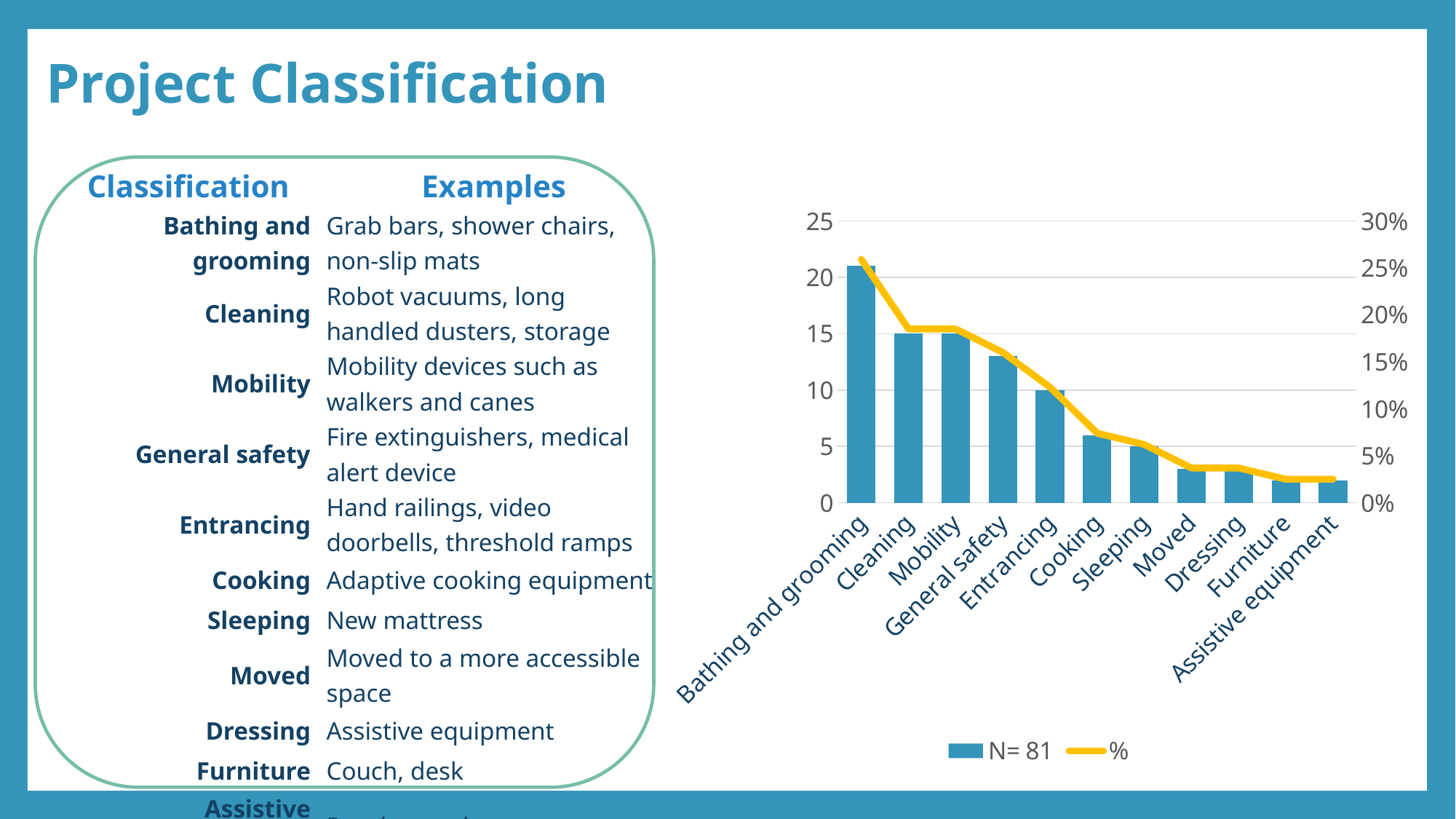
Is the N= 81 value for Moved greater or less than 5? less Do the bar values rise or fall from left to right along the x axis? fall Is the N= 81 value for General safety greater or less than 15? less What are the two entries in the chart legend? N= 81 and % Is the N= 81 value for Bathing and grooming greater or less than 20? greater What is the N= 81 value for Sleeping? 5 Which has a larger N= 81 value, General safety or Entrancing? General safety How many categories are shown on the x axis of the chart? 11 Which category has the highest bar in the chart? Bathing and grooming How many series does the chart legend list? 2 What is the N= 81 value for Cleaning? 15 What is the N= 81 value for Entrancing? 10